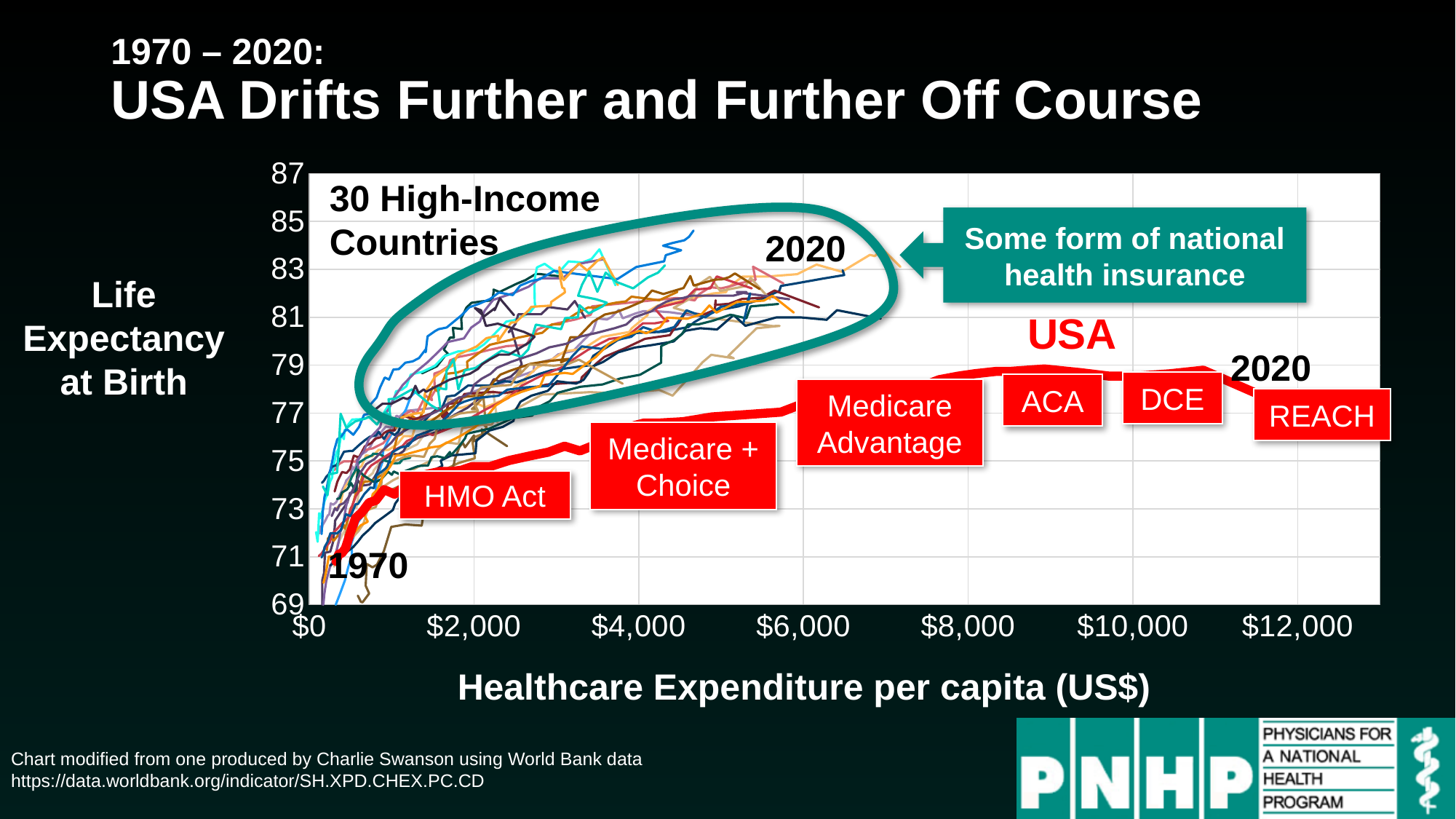
Is the highest life expectancy reached by any of the 30 high-income countries greater or less than 83? greater Is the USA's healthcare expenditure per capita in 2020 greater or less than $10,000? greater What does the teal callout say the circled 30 high-income countries have? Some form of national health insurance In 2020, which has the higher healthcare expenditure per capita: the USA or the 30 high-income countries? USA What kind of chart is shown on the slide? line chart What is the label of the horizontal axis? Healthcare Expenditure per capita (US$) Is the USA's life expectancy at birth in 2020 greater or less than 79? less In 2020, which has the higher life expectancy at birth: the USA or the 30 high-income countries? 30 high-income countries How many US policy labels (red boxes) are placed along the USA line? 6 How many high-income countries does the chart say are plotted alongside the USA? 30 Overall, does life expectancy at birth rise or fall as healthcare expenditure per capita increases along the x axis? rise